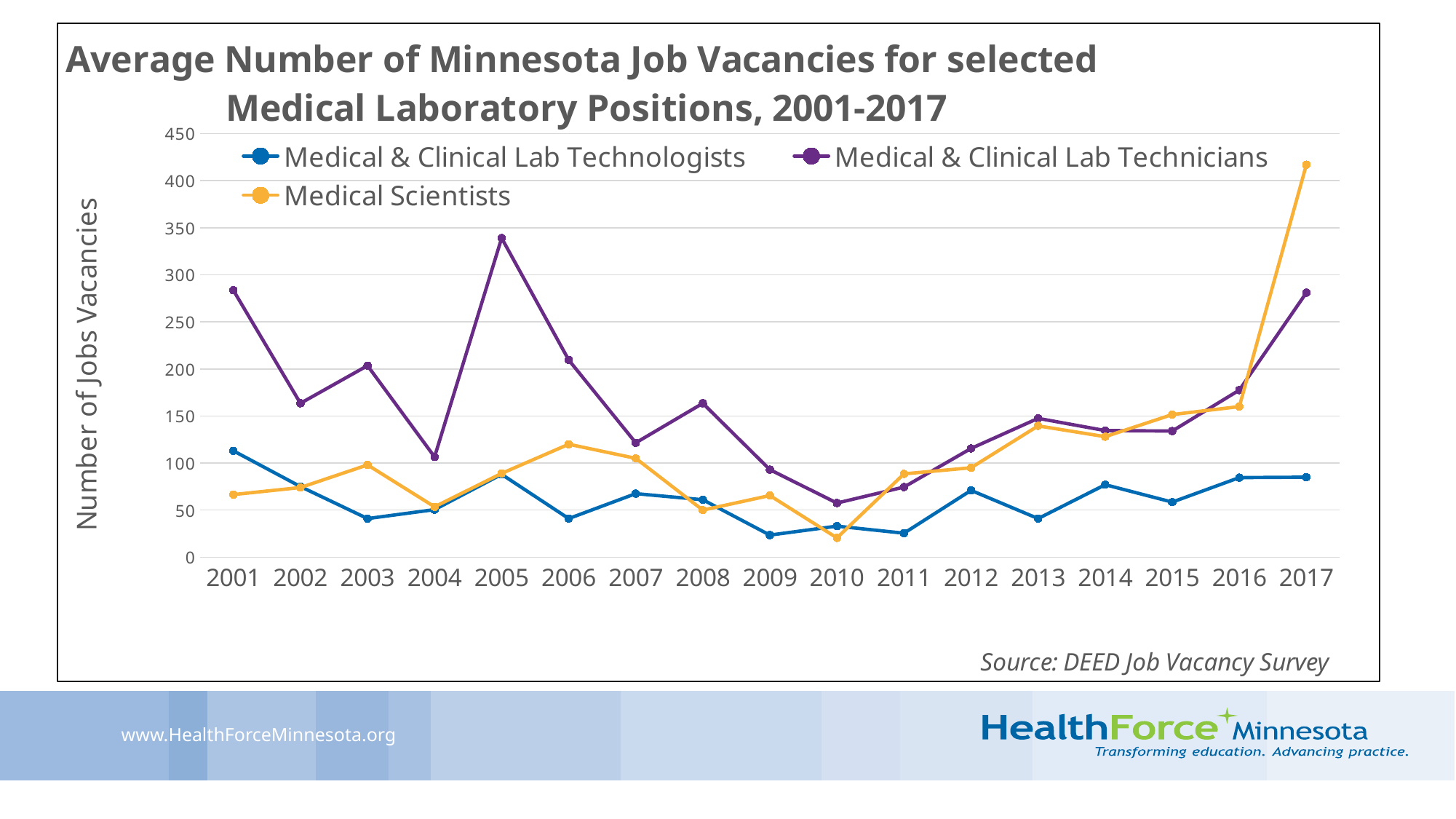
Does the Medical Scientists series rise or fall from 2013 to 2017? rise How many years are plotted along the x axis? 17 In which year does the Medical Scientists series reach its highest value? 2017 What source is cited for the chart data? DEED Job Vacancy Survey In which year does the Medical Scientists series reach its lowest value? 2010 Is the value for Medical & Clinical Lab Technologists in 2009 greater or less than 50? less How many series does the legend list? 3 What kind of chart is shown on the slide? line chart In 2001, which series has the larger value: Medical & Clinical Lab Technicians or Medical & Clinical Lab Technologists? Medical & Clinical Lab Technicians In which year does the Medical & Clinical Lab Technicians series reach its highest value? 2005 Is the value for Medical Scientists in 2017 greater or less than 400? greater Is the value for Medical & Clinical Lab Technicians in 2005 greater or less than 300? greater